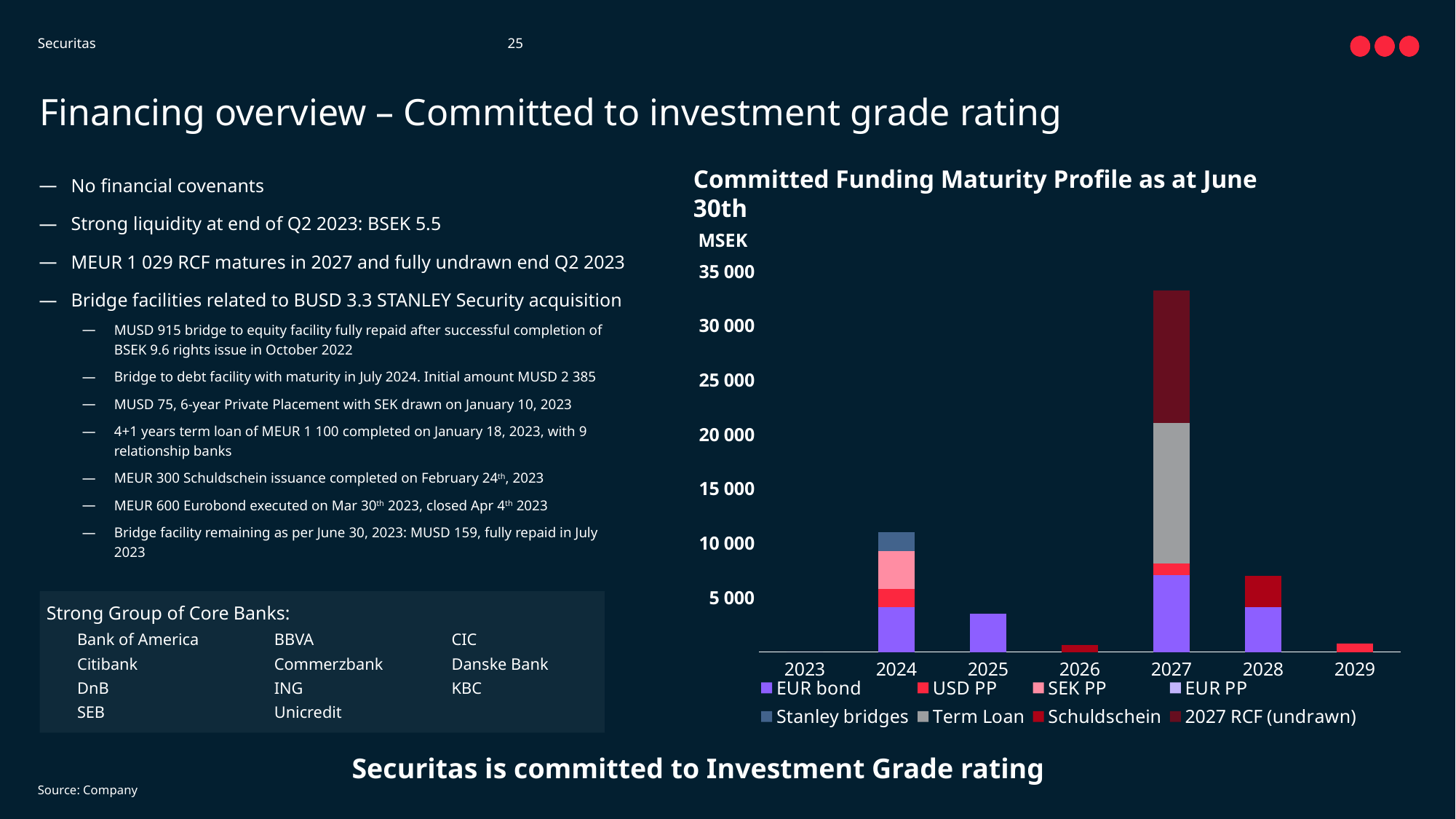
Which year has the highest total committed funding maturity in the chart? 2027 Is the total bar for 2025 greater or less than 5 000 MSEK? less What unit is shown on the y axis of the chart? MSEK Which year has a larger total bar, 2024 or 2028? 2024 Is the total bar for 2024 greater or less than 5 000 MSEK? greater What is the title of the chart on the slide? Committed Funding Maturity Profile as at June 30th What kind of chart is shown on the slide? Stacked bar chart Is the total bar for 2027 greater or less than 30 000 MSEK? greater How many years are shown on the x axis of the Committed Funding Maturity Profile chart? 7 Which year on the x axis has no bar plotted at all? 2023 How many series does the legend of the Committed Funding Maturity Profile chart list? 8